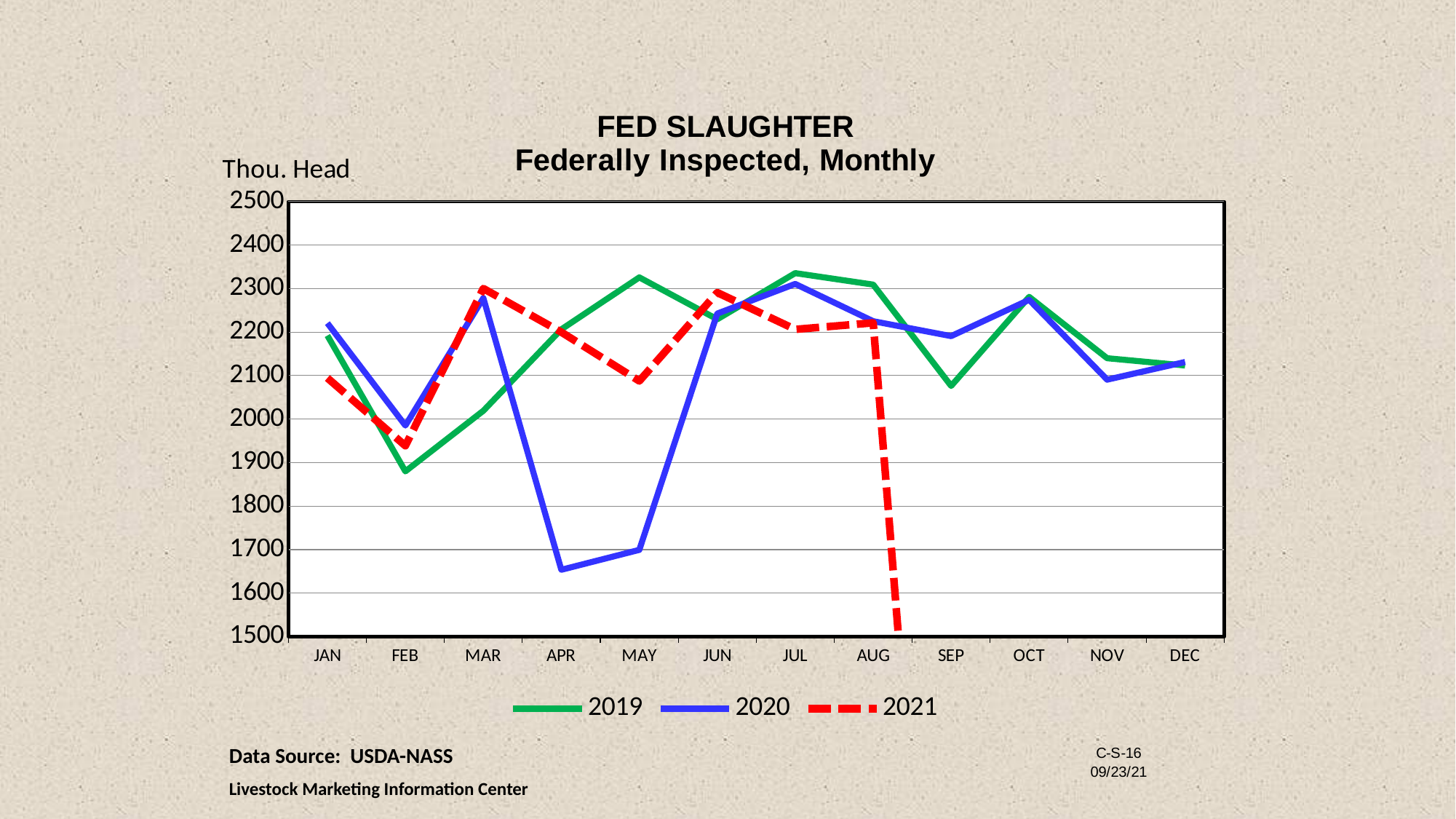
In which month does the 2020 series reach its lowest value? APR Does the 2020 series rise or fall from MAR to APR? fall Is the 2020 value for APR greater or less than 1700? less Is the 2019 value for FEB greater or less than 1900? less In which month does the 2019 series reach its lowest value? FEB What is the label on the y axis of the chart? Thou. Head How many series does the legend list? 3 How many months are shown along the x axis? 12 Which series has the higher value in APR, 2019 or 2020? 2019 Is the 2021 value for FEB greater or less than 2000? less What kind of chart is shown on the slide? line chart In which month does the 2019 series reach its highest value? JUL